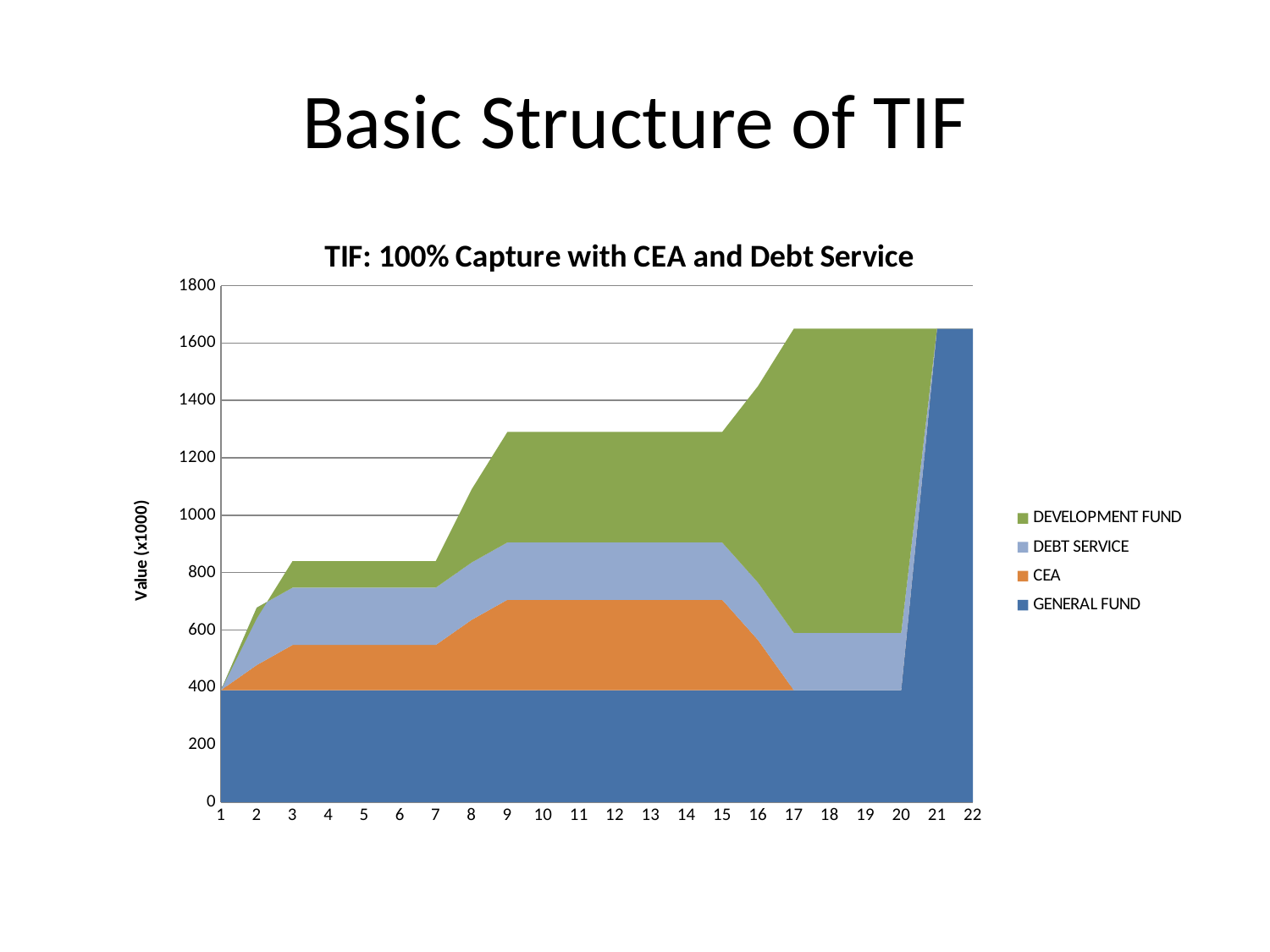
Does the total stacked value rise or fall from point 1 to point 22? rise Is the total stacked value at point 12 larger or smaller than at point 4? larger Is the total stacked value at point 18 greater or less than 1400? greater Is the total stacked value at point 10 greater or less than 1200? greater How many points are there along the x axis? 22 Is the total stacked value at point 22 greater or less than 1800? less How many series does the legend list? 4 What is the label on the vertical axis? Value (x1000) What is the title of the chart? TIF: 100% Capture with CEA and Debt Service What kind of chart is shown on the slide? Area chart